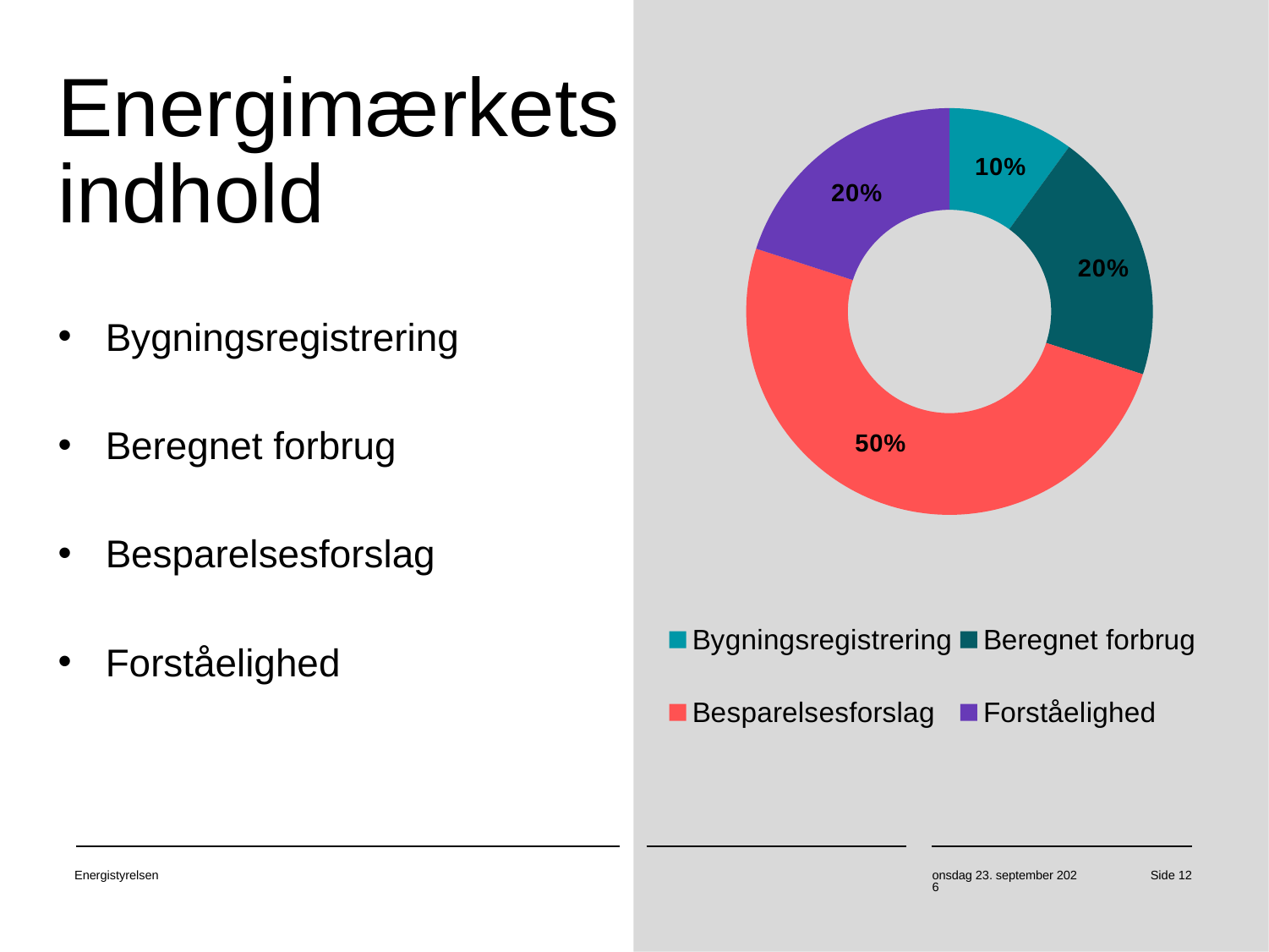
How many entries does the chart legend list? 4 What colour is the Besparelsesforslag slice? red How many slices does the chart have? 4 What percentage does the Forståelighed slice show? 20% What percentage does the Bygningsregistrering slice show? 10% What is the difference in percentage points between the Besparelsesforslag slice and the Bygningsregistrering slice? 40 percentage points What percentage does the Besparelsesforslag slice show? 50% Which category has the smallest slice in the chart? Bygningsregistrering What percentage does the Beregnet forbrug slice show? 20% What kind of chart is shown on the slide? doughnut chart Which is larger, the Besparelsesforslag slice or the Beregnet forbrug slice? Besparelsesforslag Which category has the largest slice in the chart? Besparelsesforslag